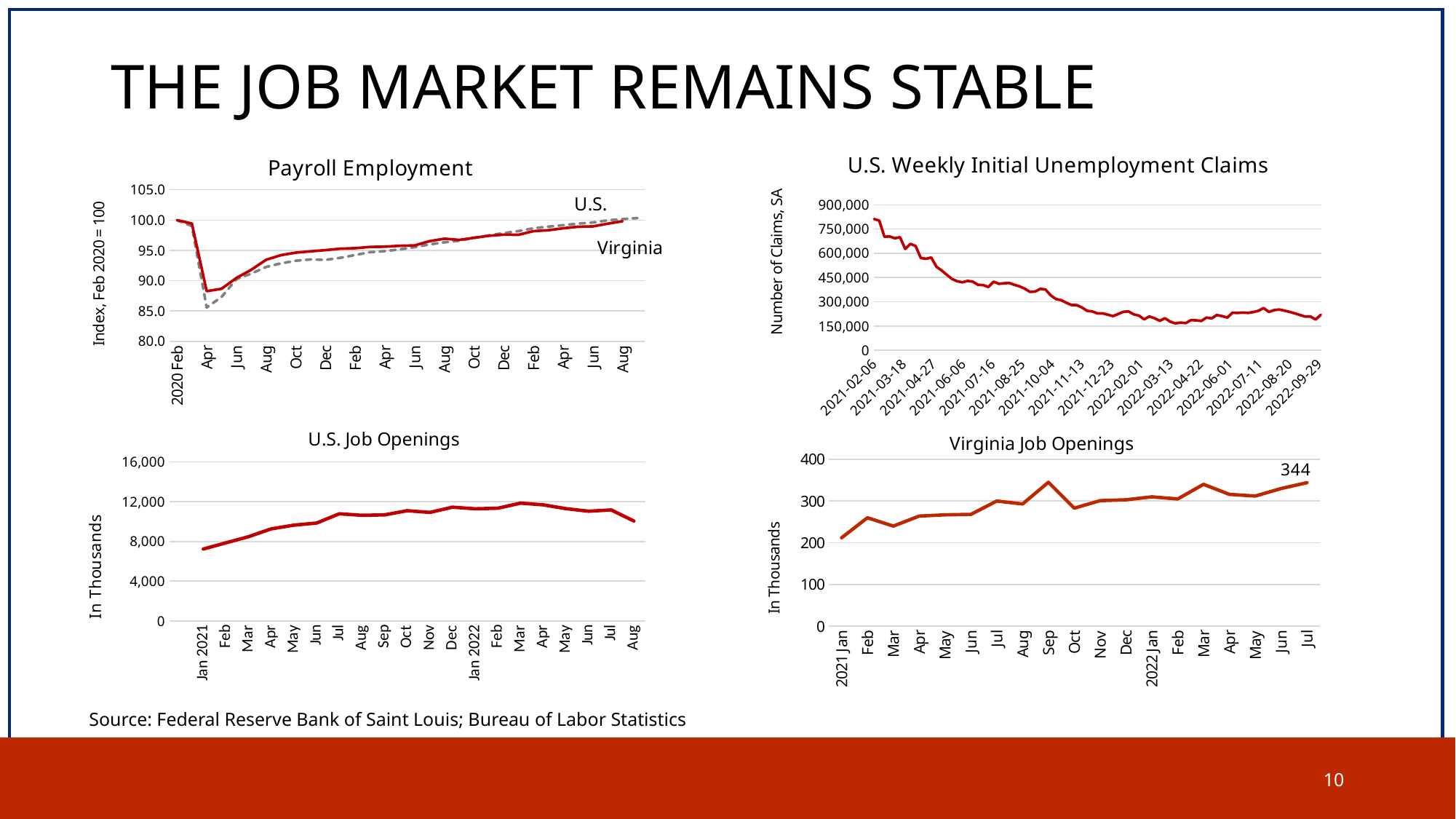
In the U.S. Job Openings chart, do the values rise or fall from Jan 2021 to Jul 2021? rise In the Payroll Employment chart, is the U.S. value for Apr 2020 greater or less than 90.0? less What kind of chart is the Virginia Job Openings chart? line chart How many charts are shown on the slide? 4 In the U.S. Weekly Initial Unemployment Claims chart, is the value at 2022-09-29 greater or less than 300,000? less In the Payroll Employment chart, which series is drawn with a dashed line? U.S. In the Virginia Job Openings chart, what is the value for Jul 2022? 344 In the U.S. Weekly Initial Unemployment Claims chart, do the values generally rise or fall from 2021-02-06 to 2022-09-29? fall In the Payroll Employment chart, how many series are plotted? 2 In the U.S. Job Openings chart, is the value for Jan 2021 greater or less than 8,000? less